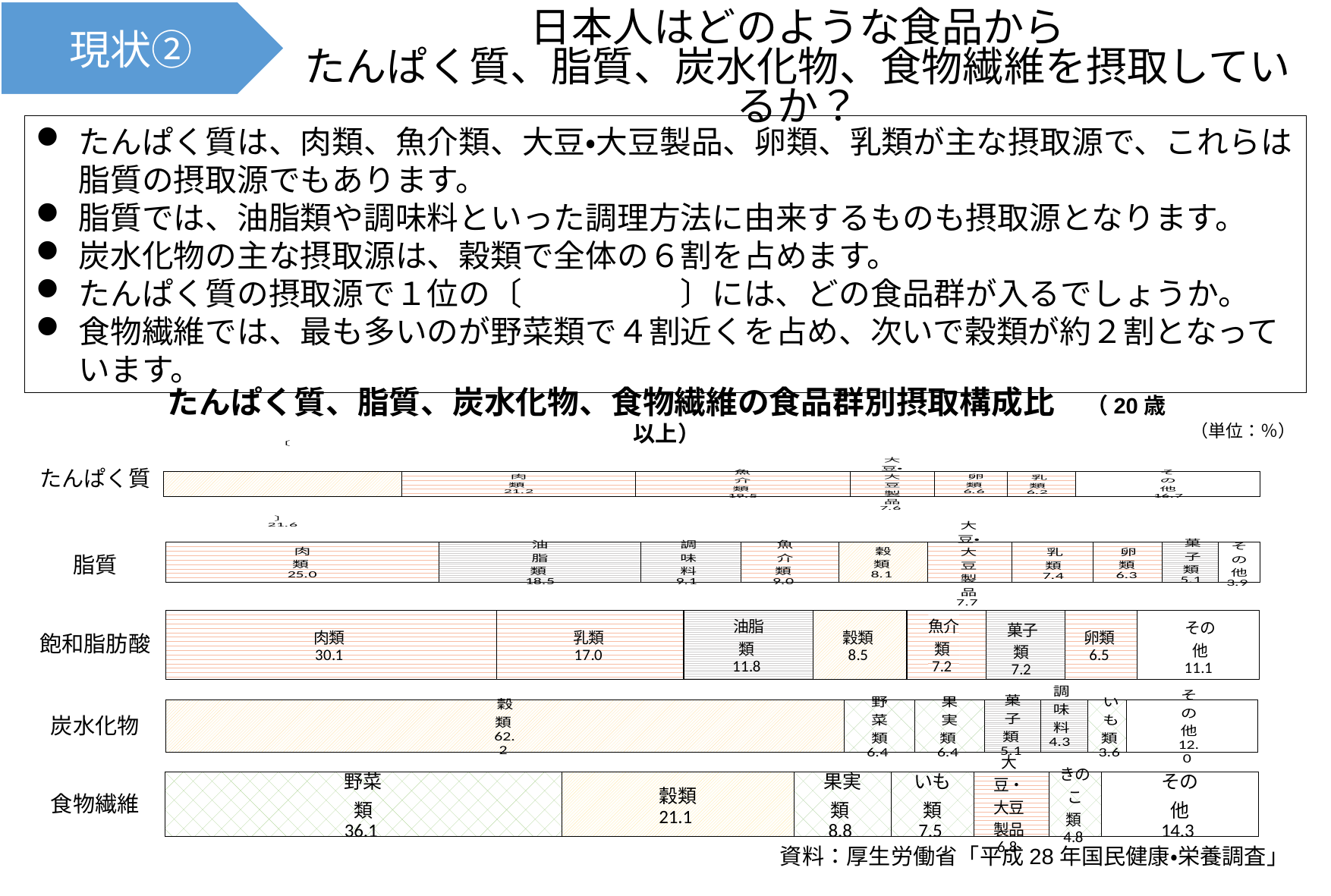
グラフの値の単位は何ですか？ % 飽和脂肪酸の肉類（30.1）と乳類（17.0）の差はいくつですか？ 13.1 飽和脂肪酸の摂取構成比で乳類の値はいくつですか？ 17.0 グラフには栄養素の棒が何本ありますか？ 5 食物繊維の摂取構成比で、穀類と果実類ではどちらが大きいですか？ 穀類 脂質の摂取構成比で肉類の値はいくつですか？ 25.0 食物繊維の摂取構成比で野菜類の値はいくつですか？ 36.1 脂質の摂取構成比で、肉類と油脂類ではどちらが大きいですか？ 肉類 飽和脂肪酸の摂取構成比で最も大きい食品群はどれですか？ 肉類 食物繊維の摂取構成比で最も大きい食品群はどれですか？ 野菜類 炭水化物の摂取構成比で穀類の値はいくつですか？ 62.2 このグラフはどの種類のグラフですか？ 積み上げ横棒グラフ（棒グラフ）